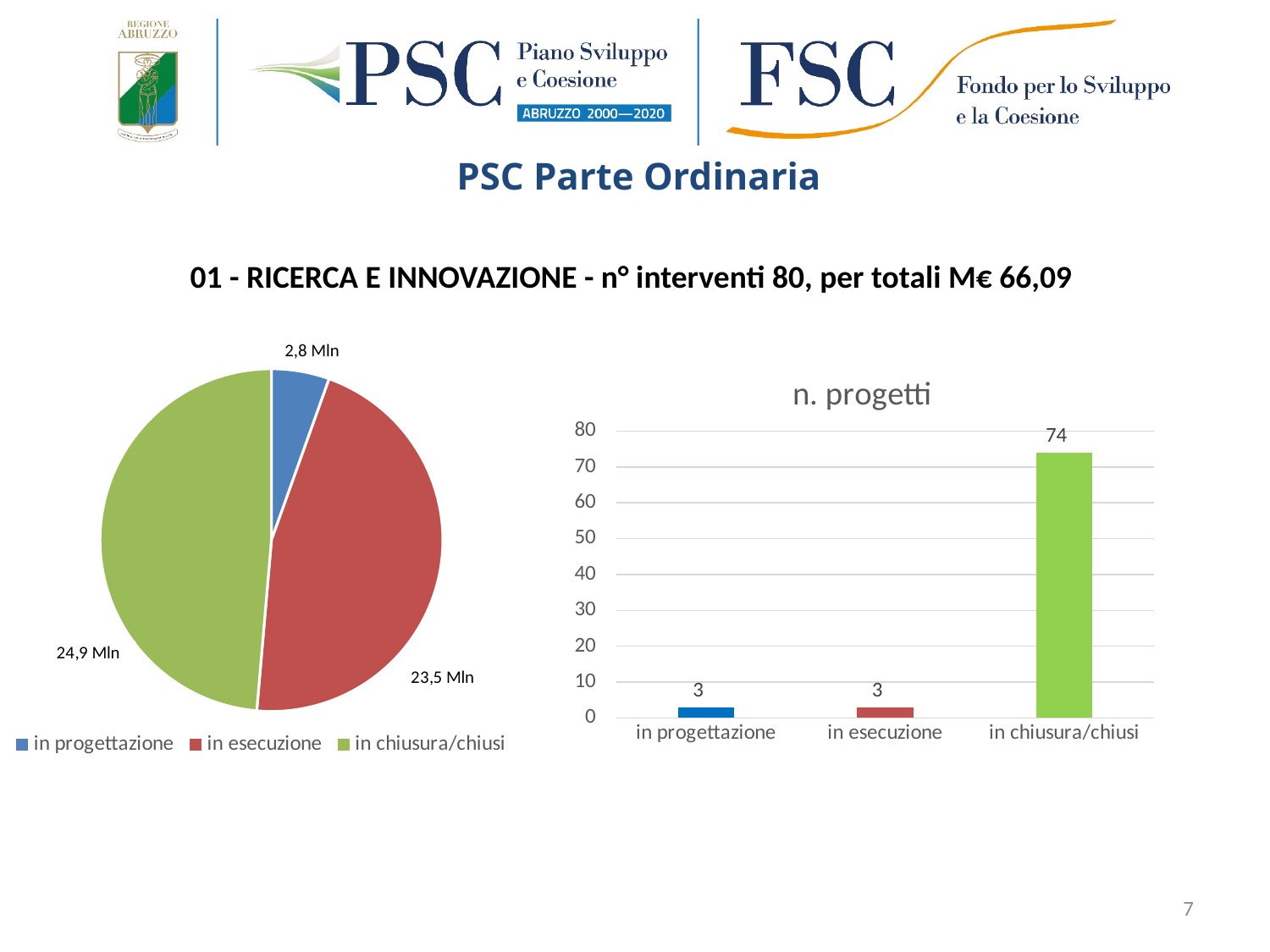
In the pie chart on the left, what is the difference between the values for 'in chiusura/chiusi' and 'in esecuzione'? 1,4 Mln In the 'n. progetti' chart, what is the value for 'in chiusura/chiusi'? 74 In the 'n. progetti' chart, is the value for 'in chiusura/chiusi' greater or less than 70? greater In the pie chart on the left, what is the value for 'in progettazione'? 2,8 Mln In the pie chart on the left, which colour represents 'in chiusura/chiusi'? green What kind of chart is the 'n. progetti' chart? bar chart In the pie chart on the left, which category has the largest slice? in chiusura/chiusi In the 'n. progetti' chart, what is the difference between the values for 'in chiusura/chiusi' and 'in progettazione'? 71 In the pie chart on the left, which category has the smallest slice? in progettazione In the pie chart on the left, what is the value for 'in esecuzione'? 23,5 Mln In the pie chart on the left, how many categories does the legend list? 3 In the 'n. progetti' chart, what is the value for 'in esecuzione'? 3